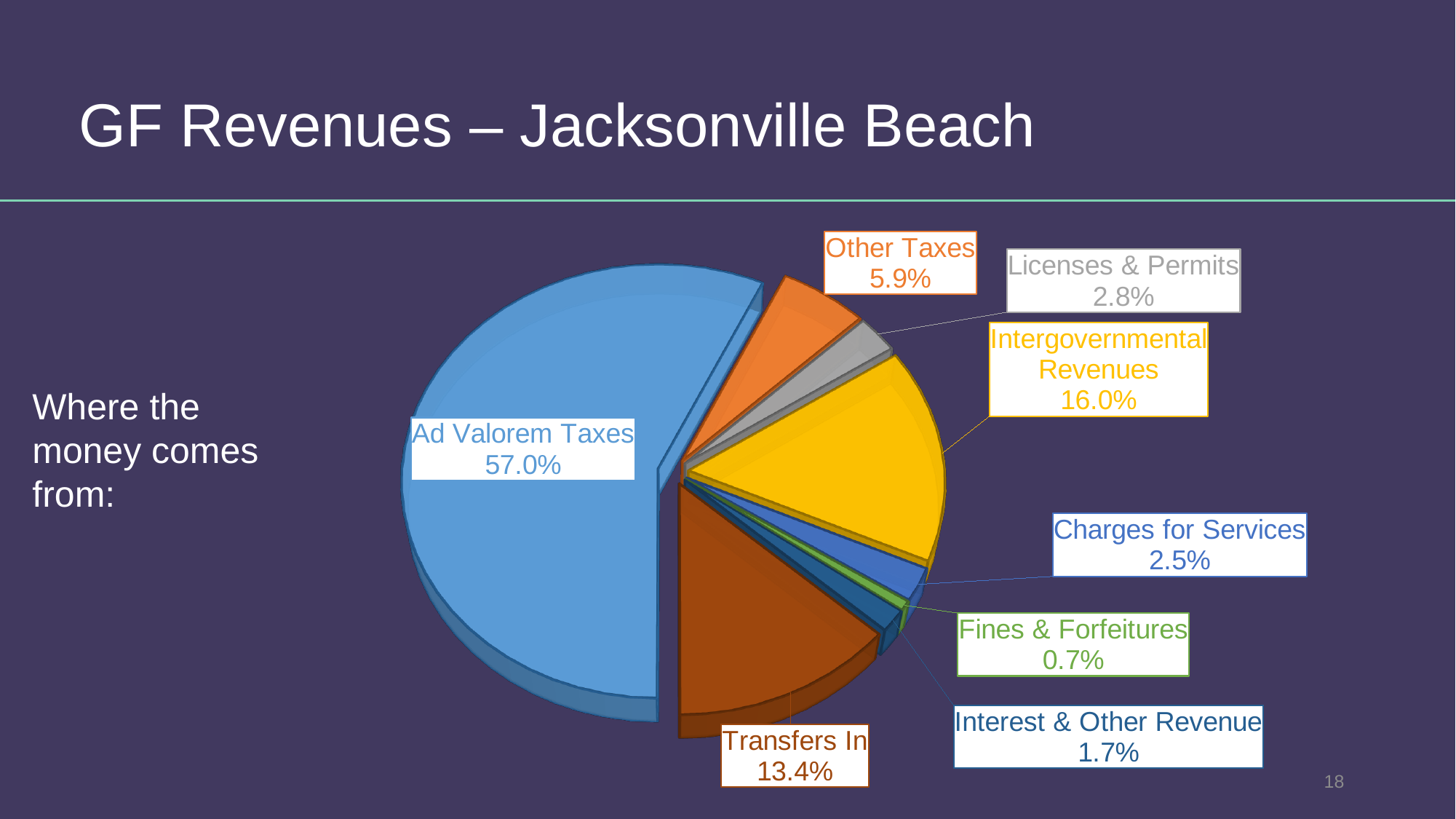
Which revenue source has the largest slice of the pie? Ad Valorem Taxes What is the value shown for Transfers In? 13.4% What percentage of the pie is Intergovernmental Revenues? 16.0% What share is labelled for Fines & Forfeitures? 0.7% Which revenue source has the smallest slice of the pie? Fines & Forfeitures What share of GF revenues comes from Ad Valorem Taxes? 57.0% How many slices does the pie chart have? 8 What is the difference in percentage points between Ad Valorem Taxes and Intergovernmental Revenues? 41.0 percentage points Which is larger, Other Taxes or Licenses & Permits? Other Taxes What is the combined share of Charges for Services and Interest & Other Revenue? 4.2% What is the title of the slide containing the chart? GF Revenues – Jacksonville Beach What kind of chart is shown on the slide? Pie chart